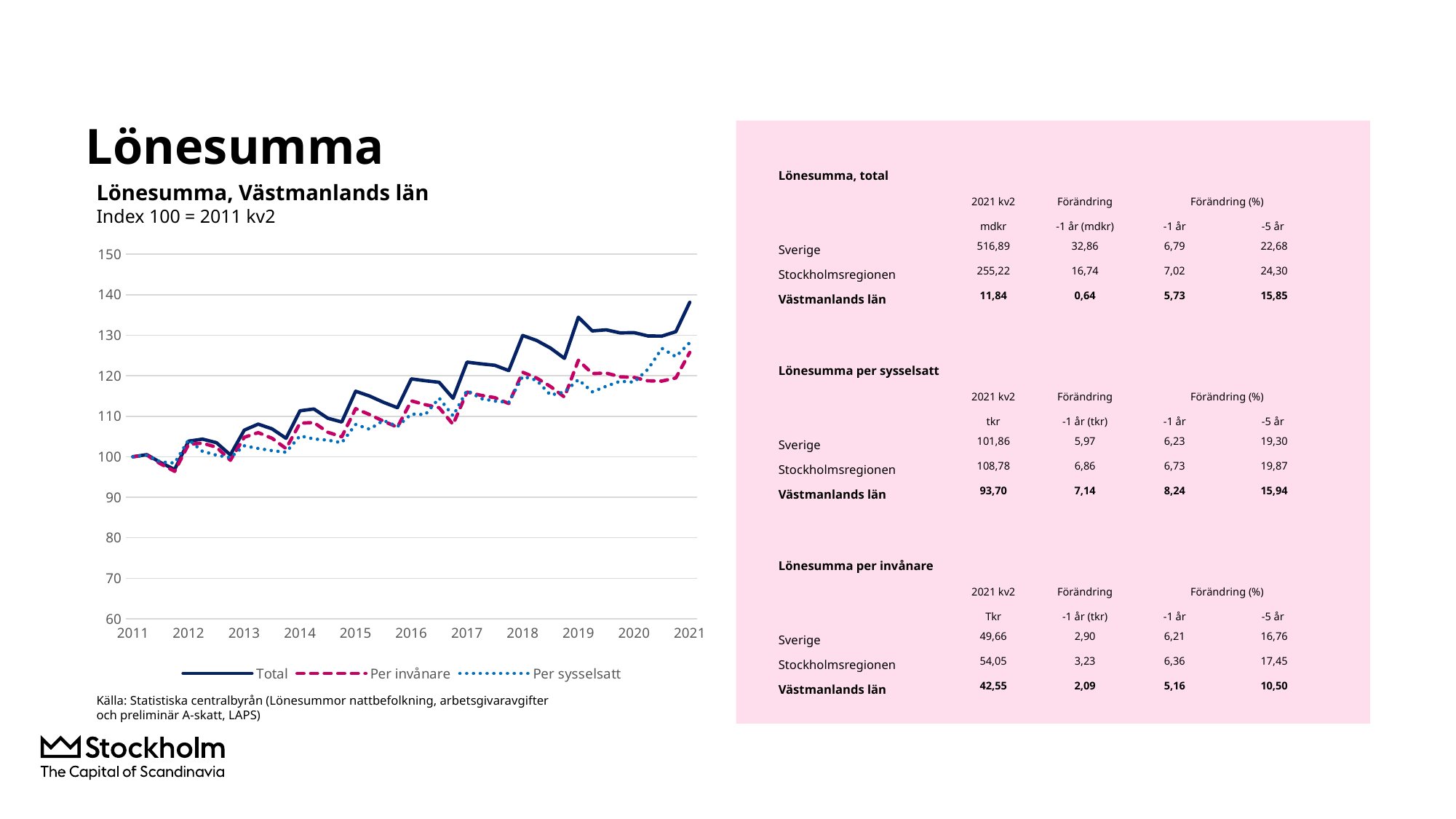
Which series has the highest value at the end of 2021? Total What is the index value of the series at the base period 2011 kv2? 100 Is the value of the Total series at 2018 greater or less than 120? greater Is the value of the Per sysselsatt series at 2016 greater or less than 120? less Is the value of the Total series at the end of 2021 greater or less than 130? greater At the end of 2021, which is larger: the Total series or the Per invånare series? Total What is the title of the line chart? Lönesumma, Västmanlands län What kind of chart is shown on the slide? line chart How many series does the legend of the line chart list? 3 Which series in the line chart is drawn as a solid dark blue line? Total Does the Total series generally rise or fall from 2011 to 2021? rise